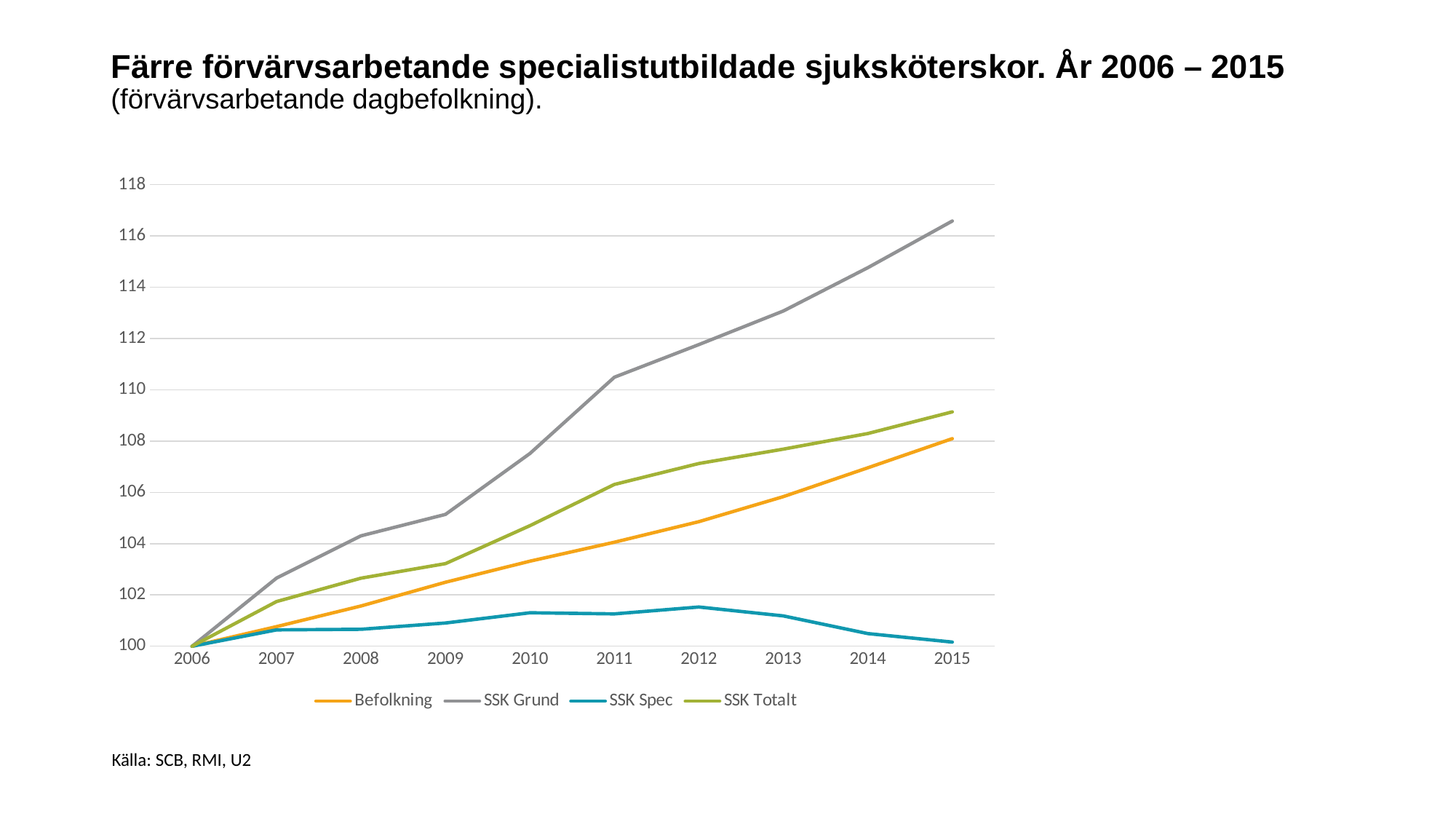
Is the value for SSK Totalt in 2015 greater or less than 108? greater Which series has the lowest value in 2015? SSK Spec Which series has the highest value in 2015? SSK Grund What is the value of all four series in 2006? 100 Does the SSK Grund line rise or fall from 2006 to 2015? rises How many series does the legend list? 4 Does the SSK Spec line rise or fall from 2012 to 2015? falls Is the value for SSK Spec in 2012 greater or less than 102? less What kind of chart is shown on the slide? line chart Is the value for SSK Grund in 2015 greater or less than 116? greater How many years are plotted along the x axis? 10